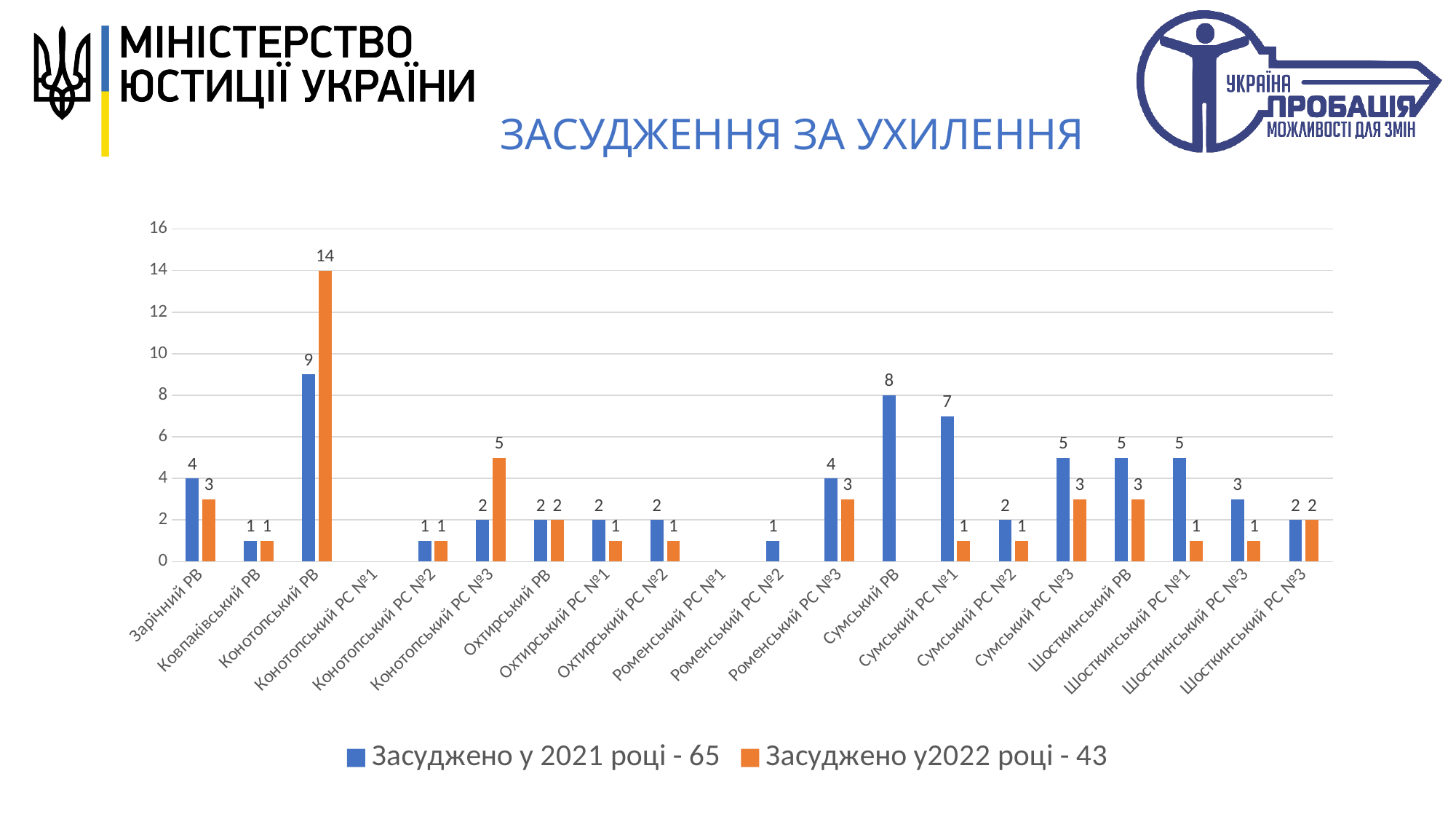
What is the difference between the 2022 and 2021 values for Конотопський РВ? 5 What is the difference between the 2021 and 2022 values for Сумський РС №1? 6 What is the title of the chart? ЗАСУДЖЕННЯ ЗА УХИЛЕННЯ Is the 2022 value for Конотопський РВ greater or less than 12? greater What kind of chart is shown on the slide? Bar chart For Шосткинський РС №1, which series has the larger value: 2021 or 2022? 2021 How many series does the legend list? 2 What is the value for Сумський РВ in the series 'Засуджено у 2021 році - 65'? 8 What is the value for Конотопський РС №3 in the series 'Засуджено у2022 році - 43'? 5 What is the value for Конотопський РВ in the series 'Засуджено у2022 році - 43'? 14 Which category has the highest value in the series 'Засуджено у 2021 році - 65'? Конотопський РВ Which category has the highest value in the series 'Засуджено у2022 році - 43'? Конотопський РВ